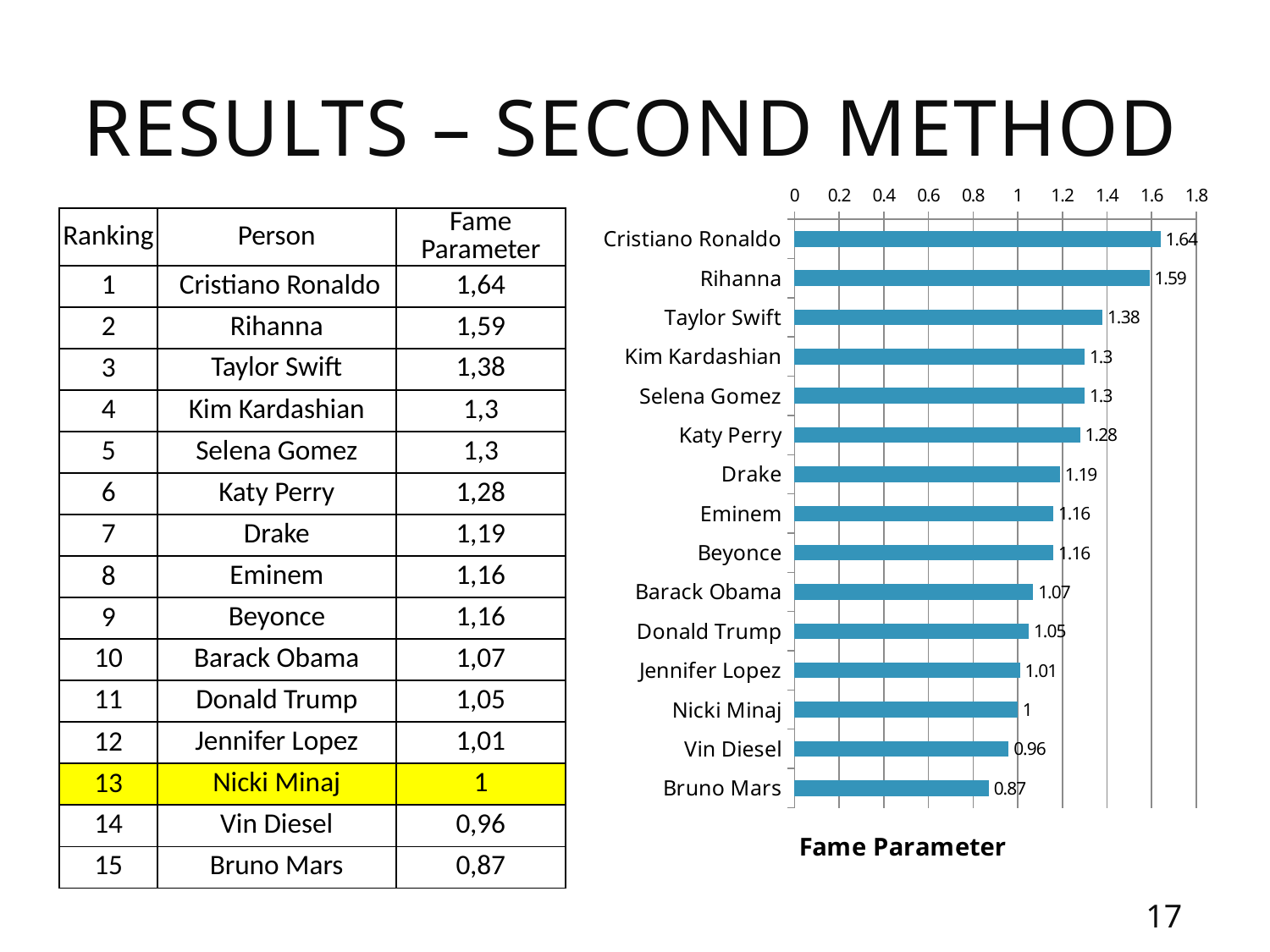
What kind of chart is shown on the slide? Bar chart What is the Fame Parameter value for Barack Obama in the chart? 1.07 What is the title shown below the chart? Fame Parameter Which person has the highest Fame Parameter in the chart? Cristiano Ronaldo What is the Fame Parameter value for Jennifer Lopez in the chart? 1.01 Who has a larger Fame Parameter, Drake or Donald Trump? Drake What is the difference between the Fame Parameter values of Cristiano Ronaldo and Rihanna? 0.05 Which person has the lowest Fame Parameter in the chart? Bruno Mars Is the Fame Parameter value for Vin Diesel greater or less than 1? less How many people are shown in the chart? 15 What is the Fame Parameter value for Taylor Swift in the chart? 1.38 What is the difference between the Fame Parameter values of Nicki Minaj and Bruno Mars? 0.13